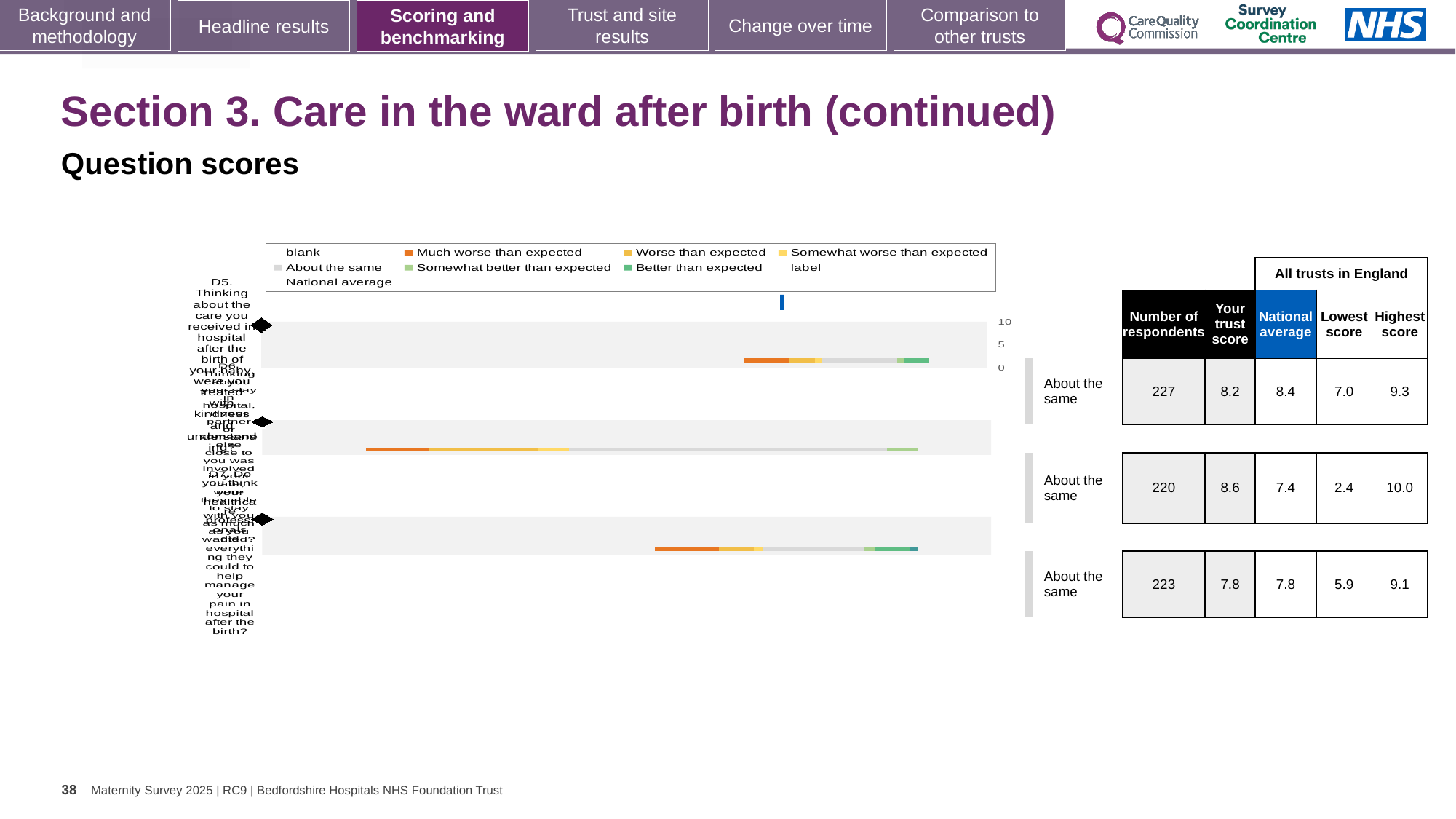
What kind of chart is shown on the slide? bar chart What benchmark category label is shown beside each of the three bars in the chart? About the same How many question rows (bars) are plotted in the chart? 3 What colour does the legend use for 'Much worse than expected'? orange How many entries does the chart's legend list? 9 What colour does the legend use for 'Better than expected'? green